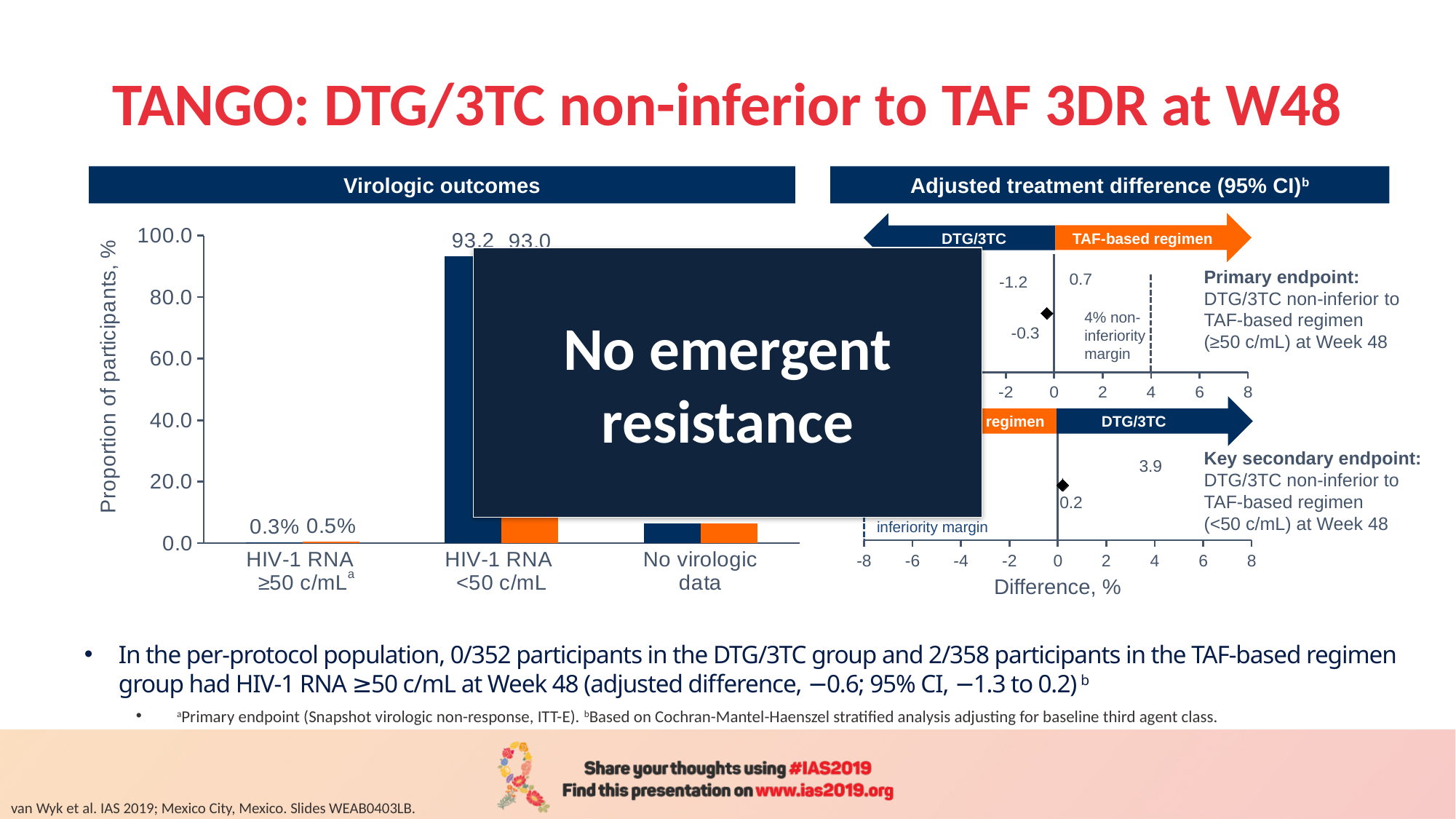
What kind of chart is the 'Virologic outcomes' chart on the left? bar chart How many categories are shown on the x axis of the 'Virologic outcomes' chart? 3 In the 'Virologic outcomes' chart, what value is labelled on the navy bar for HIV-1 RNA <50 c/mL? 93.2 In the 'Virologic outcomes' chart, what is the difference between the navy and orange bars for HIV-1 RNA <50 c/mL? 0.2 In the 'Virologic outcomes' chart, is the navy bar for 'No virologic data' greater or less than 20.0? less In the 'Virologic outcomes' chart, what value is labelled on the orange bar for HIV-1 RNA <50 c/mL? 93.0 In the 'Adjusted treatment difference (95% CI)' chart, what is the upper confidence limit shown for the key secondary endpoint? 3.9 In the 'Virologic outcomes' chart, what value is labelled on the navy bar for HIV-1 RNA ≥50 c/mL? 0.3% In the 'Virologic outcomes' chart, which category has the highest bars? HIV-1 RNA <50 c/mL In the 'Adjusted treatment difference (95% CI)' chart, what is the point estimate shown for the primary endpoint? -0.3 In the 'Virologic outcomes' chart, what value is labelled on the orange bar for HIV-1 RNA ≥50 c/mL? 0.5% What is the y-axis label of the 'Virologic outcomes' chart? Proportion of participants, %